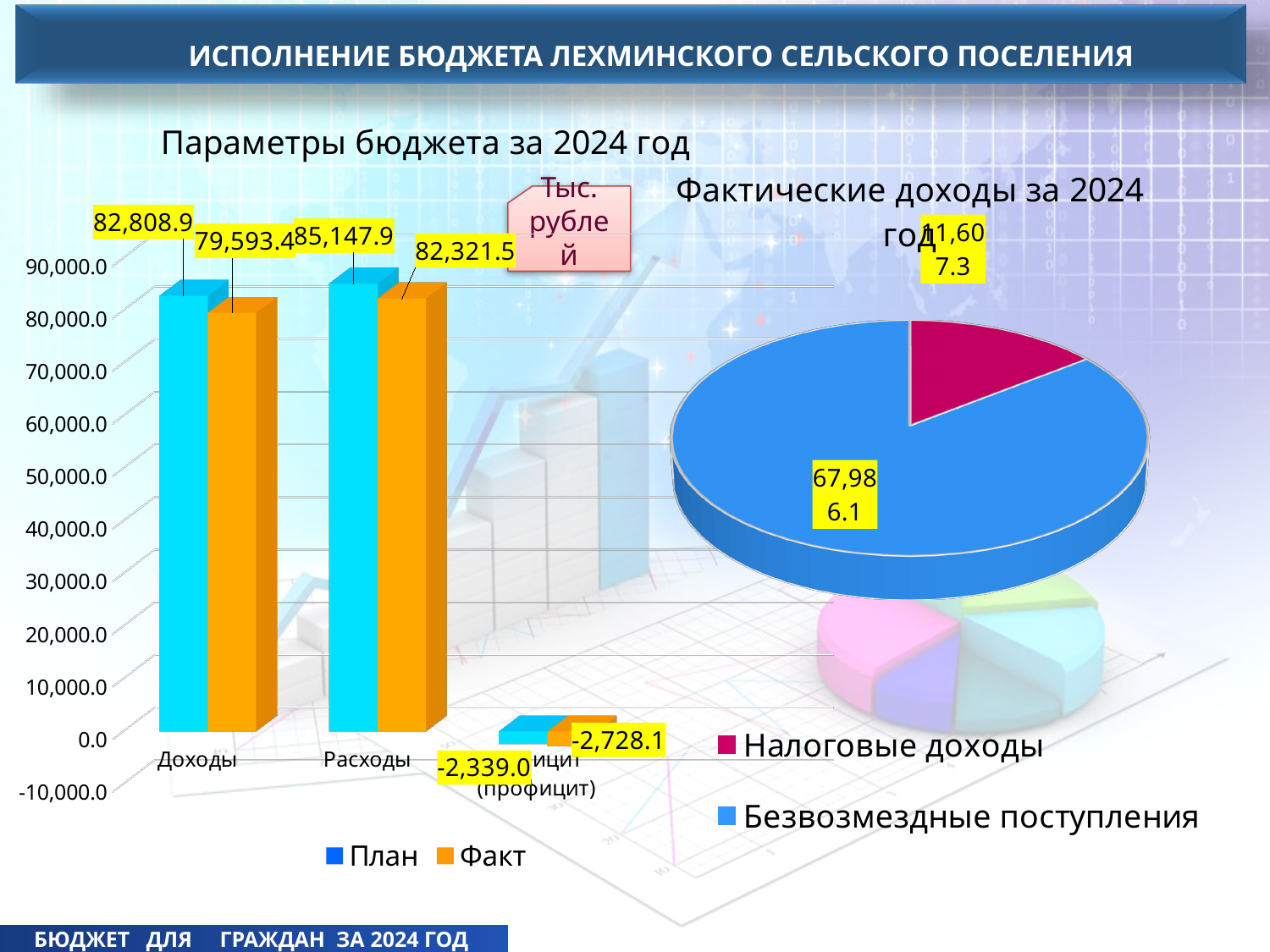
In the bar chart 'Параметры бюджета за 2024 год', what is the План value for Доходы? 82,808.9 In the bar chart 'Параметры бюджета за 2024 год', which is larger: the Факт value for Доходы or the Факт value for Расходы? Расходы In the bar chart 'Параметры бюджета за 2024 год', how many series does the legend list? 2 In the bar chart 'Параметры бюджета за 2024 год', what is the План value for Дефицит (профицит)? -2,339.0 In the bar chart 'Параметры бюджета за 2024 год', what is the Факт value for Дефицит (профицит)? -2,728.1 In the bar chart 'Параметры бюджета за 2024 год', what is the Факт value for Расходы? 82,321.5 In the pie chart 'Фактические доходы за 2024 год', which category has the largest slice? Безвозмездные поступления What type of chart is the chart on the right titled 'Фактические доходы за 2024 год'? pie chart In the bar chart 'Параметры бюджета за 2024 год', how many categories are shown on the x axis? 3 In the bar chart 'Параметры бюджета за 2024 год', what is the difference between the План and Факт values for Доходы? 3,215.5 In the bar chart 'Параметры бюджета за 2024 год', what is the difference between the План and Факт values for Расходы? 2,826.4 In the pie chart 'Фактические доходы за 2024 год', what is the value for Безвозмездные поступления? 67,986.1